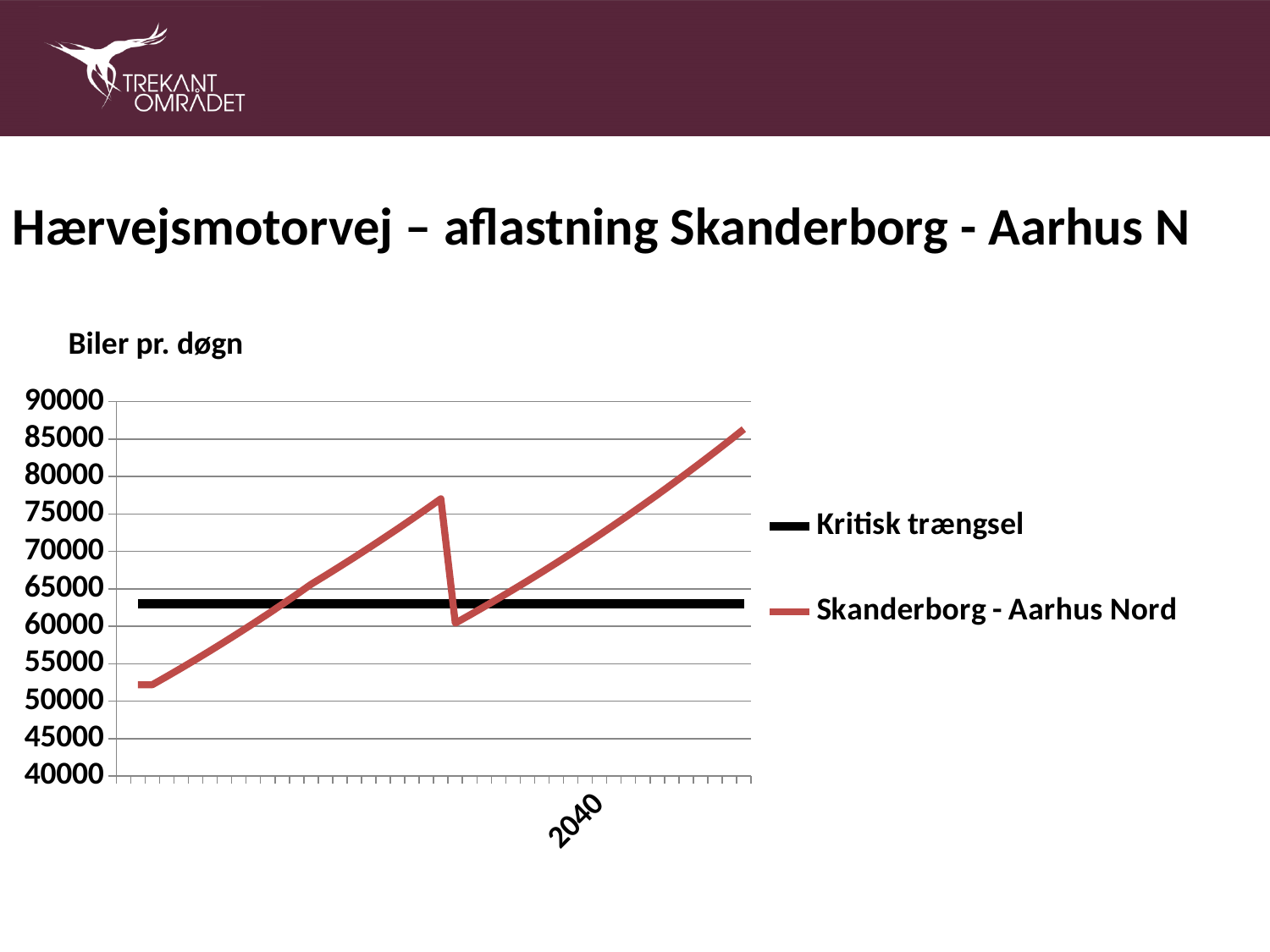
Is the starting value of the Skanderborg - Aarhus Nord line, at the left edge of the chart, greater or less than 55000? less What label is shown above the vertical axis of the chart? Biler pr. døgn Is the value of the Skanderborg - Aarhus Nord line at its peak just before the sharp drop greater or less than 75000? greater Is the value of the Kritisk trængsel line greater or less than 65000? less What kind of chart is shown on the slide? line chart What is the title of the slide's chart? Hærvejsmotorvej – aflastning Skanderborg - Aarhus N At the left edge of the chart, which series has the higher value: Kritisk trængsel or Skanderborg - Aarhus Nord? Kritisk trængsel Does the Kritisk trængsel line rise, fall or stay flat along the x axis? stays flat At the right edge of the chart, which series has the higher value: Kritisk trængsel or Skanderborg - Aarhus Nord? Skanderborg - Aarhus Nord How many series does the legend list? 2